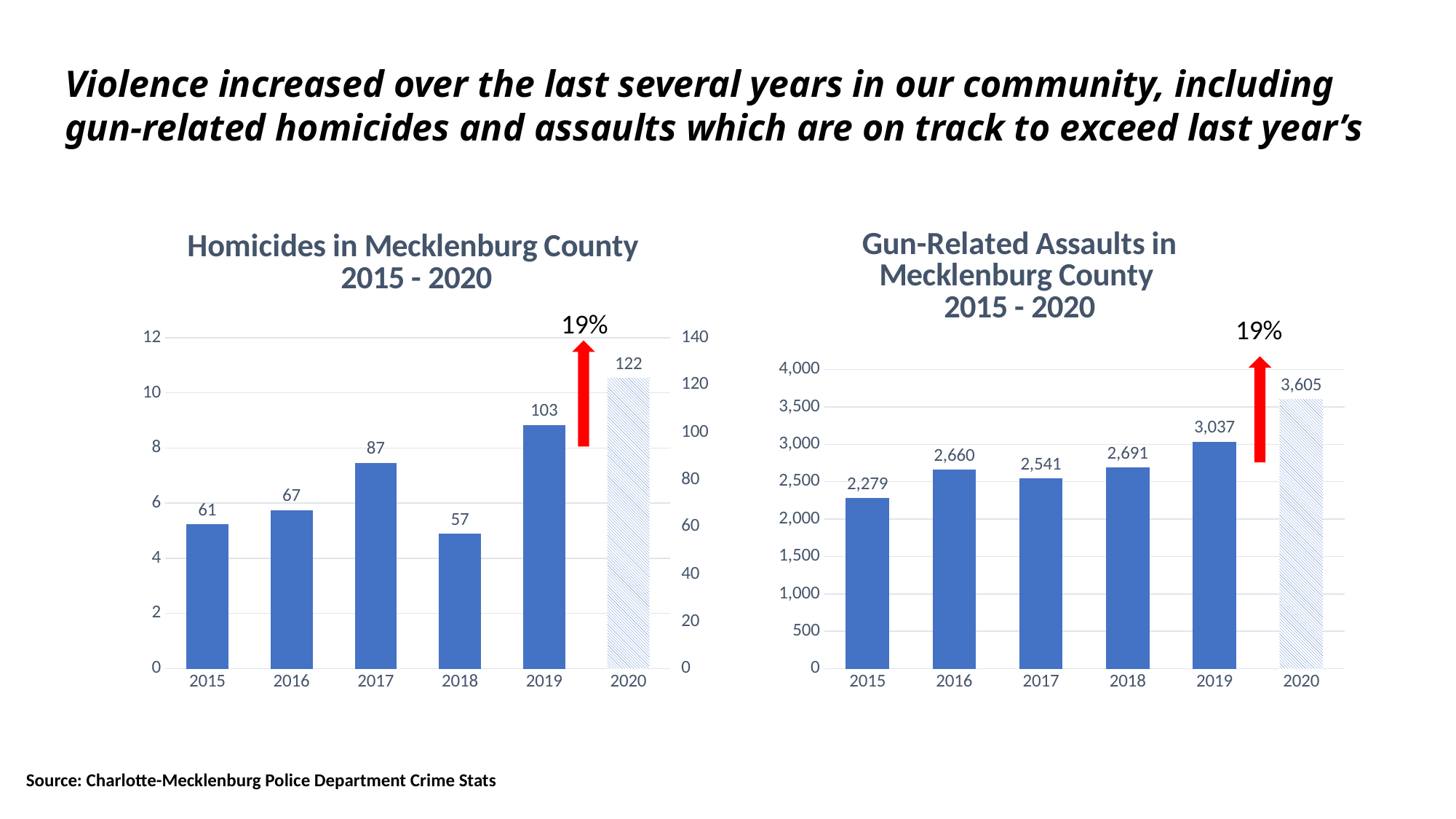
In the Gun-Related Assaults in Mecklenburg County chart, what is the difference between the 2019 and 2018 values? 346 In the Homicides in Mecklenburg County chart, which year has the lowest value? 2018 What percentage increase is annotated with a red arrow above the 2020 bar in the Gun-Related Assaults in Mecklenburg County chart? 19% In the Gun-Related Assaults in Mecklenburg County chart, which is larger, the value for 2016 or the value for 2017? 2016 In the Gun-Related Assaults in Mecklenburg County chart, what is the value for 2017? 2,541 How many years are shown on the x axis of the Gun-Related Assaults in Mecklenburg County chart? 6 What kind of chart is the Homicides in Mecklenburg County chart? Bar chart In the Homicides in Mecklenburg County chart, which year has the highest value? 2020 In the Homicides in Mecklenburg County chart, what is the value for 2019? 103 In the Homicides in Mecklenburg County chart, what is the difference between the 2020 and 2019 values? 19 In the Homicides in Mecklenburg County chart, which is larger, the value for 2016 or the value for 2018? 2016 In the Gun-Related Assaults in Mecklenburg County chart, which year has the lowest value? 2015